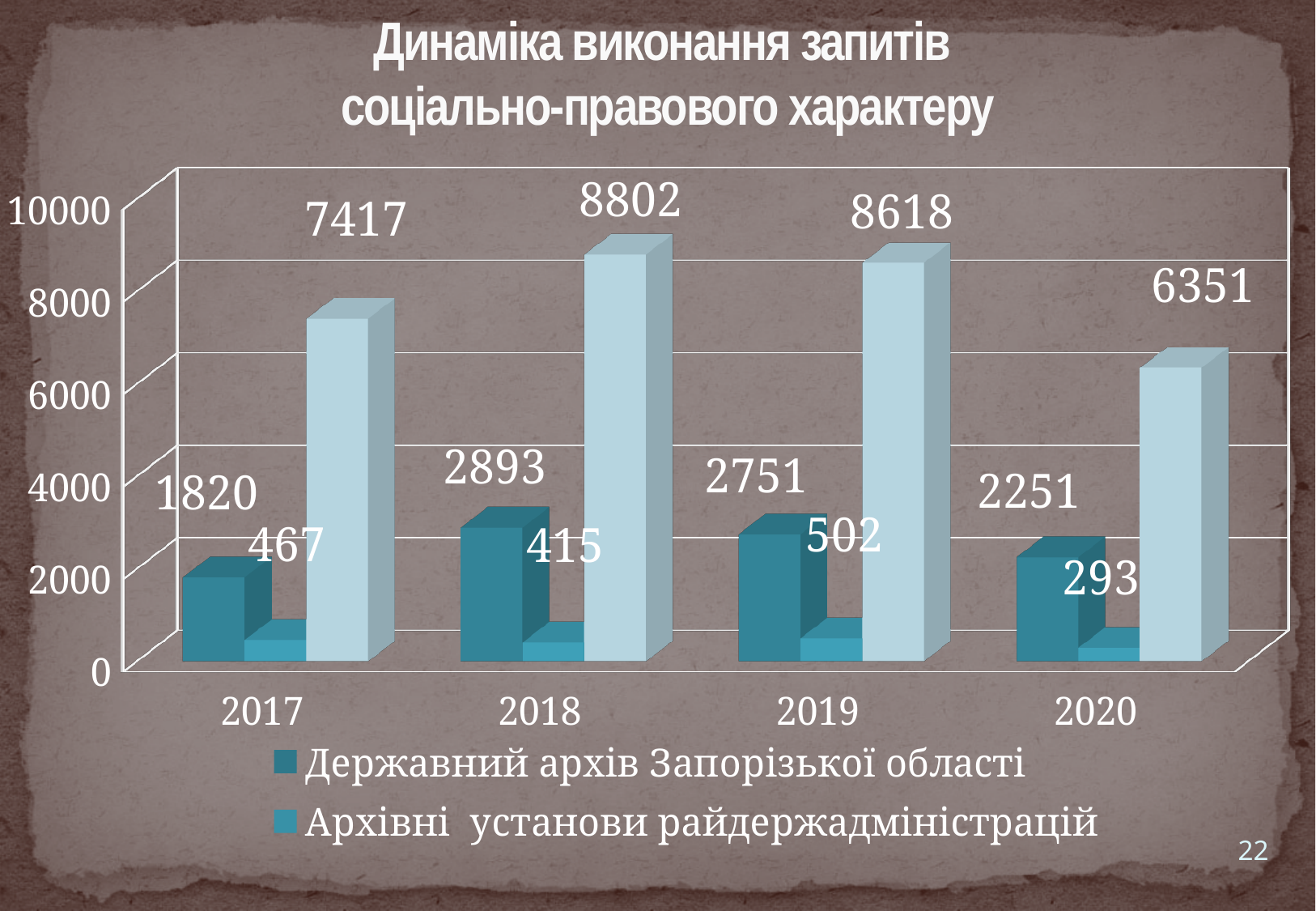
How many series does the legend list? 2 In which year is the value for Державний архів Запорізької області the highest? 2018 What is the title of the chart? Динаміка виконання запитів соціально-правового характеру How many years are shown on the x axis? 4 In which year is the value for Архівні установи райдержадміністрацій the lowest? 2020 Which is larger: the Архівні установи райдержадміністрацій value for 2017 or for 2018? 2017 What is the largest value labelled for 2018? 8802 What is the value for Державний архів Запорізької області in 2018? 2893 What kind of chart is shown on the slide? Bar chart What is the value for Державний архів Запорізької області in 2020? 2251 What is the difference between the Державний архів Запорізької області values for 2018 and 2017? 1073 What is the value for Архівні установи райдержадміністрацій in 2019? 502